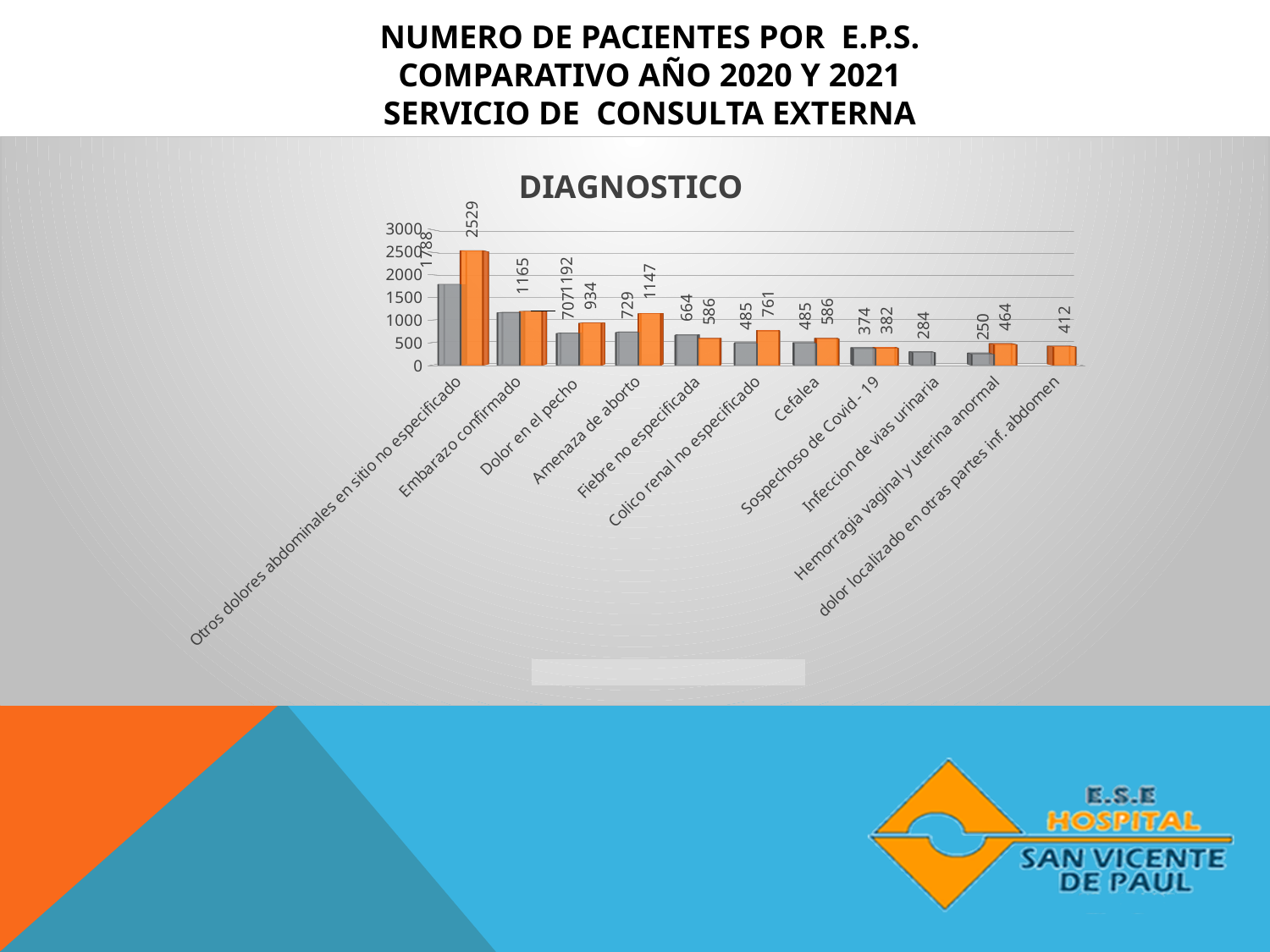
Which category has the highest orange bar? Otros dolores abdominales en sitio no especificado What is the value of the orange bar for 'Cefalea'? 586 What is the title of the chart? DIAGNOSTICO Which category has the lowest gray bar? Hemorragia vaginal y uterina anormal What is the value of the gray bar for 'Amenaza de aborto'? 729 For 'Fiebre no especificada', which bar is larger, the gray one or the orange one? gray What is the difference between the orange bar (2529) and the gray bar (1788) for 'Otros dolores abdominales en sitio no especificado'? 741 What is the difference between the orange bar (464) and the gray bar (250) for 'Hemorragia vaginal y uterina anormal'? 214 What kind of chart is the DIAGNOSTICO chart? bar chart How many diagnosis categories are shown on the x axis of the DIAGNOSTICO chart? 11 What value is shown for 'Infeccion de vias urinaria'? 284 What is the value of the orange bar for 'Otros dolores abdominales en sitio no especificado'? 2529